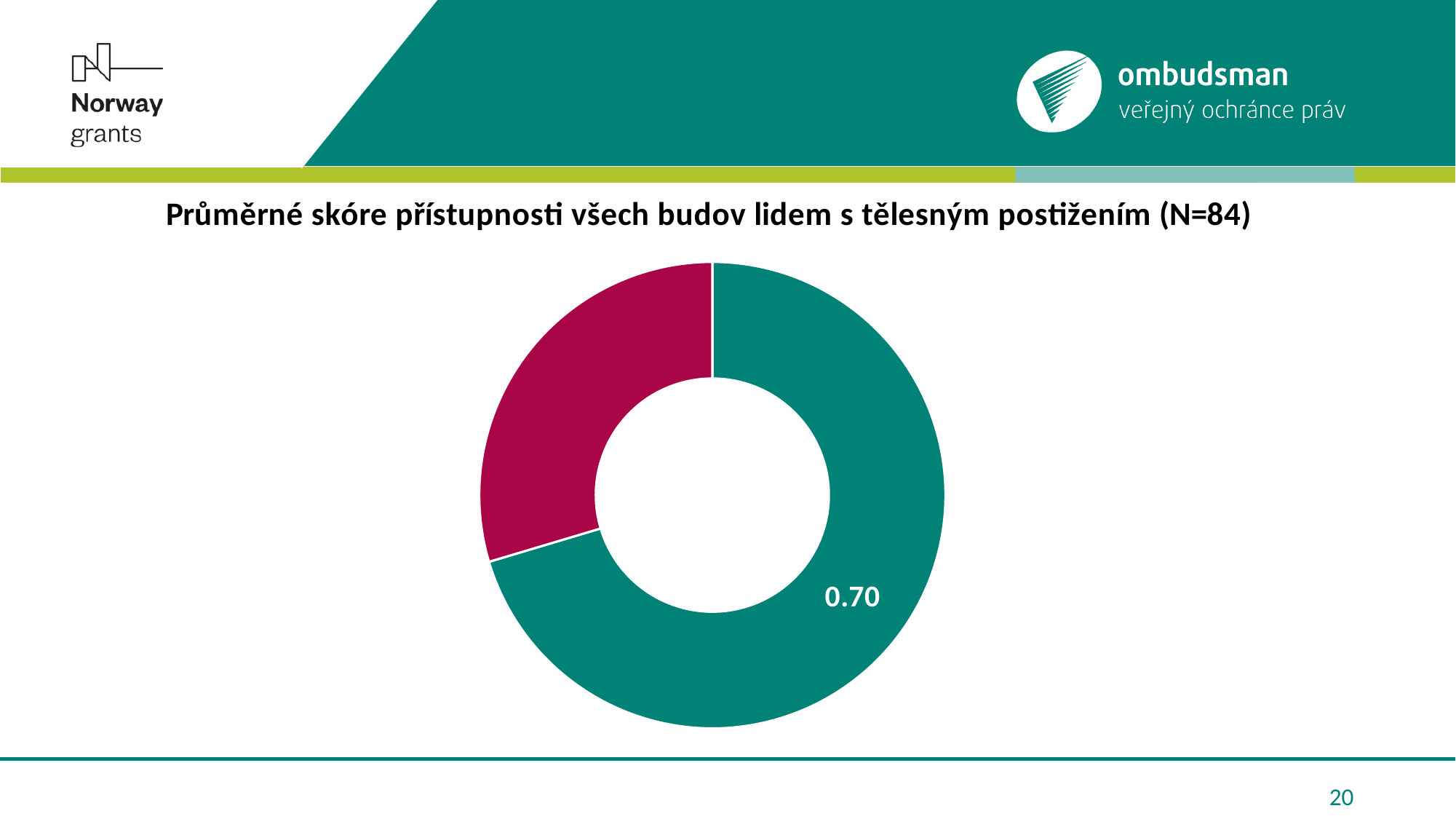
What is the title of the chart? Průměrné skóre přístupnosti všech budov lidem s tělesným postižením (N=84) What sample size (N) is stated in the chart title? 84 Which slice of the doughnut chart is larger, the teal one or the crimson one? the teal one What kind of chart is shown on the slide? doughnut chart What value is printed on the teal slice of the doughnut chart? 0.70 How many slices does the doughnut chart have? 2 Which slice of the doughnut chart is the smallest? the crimson slice